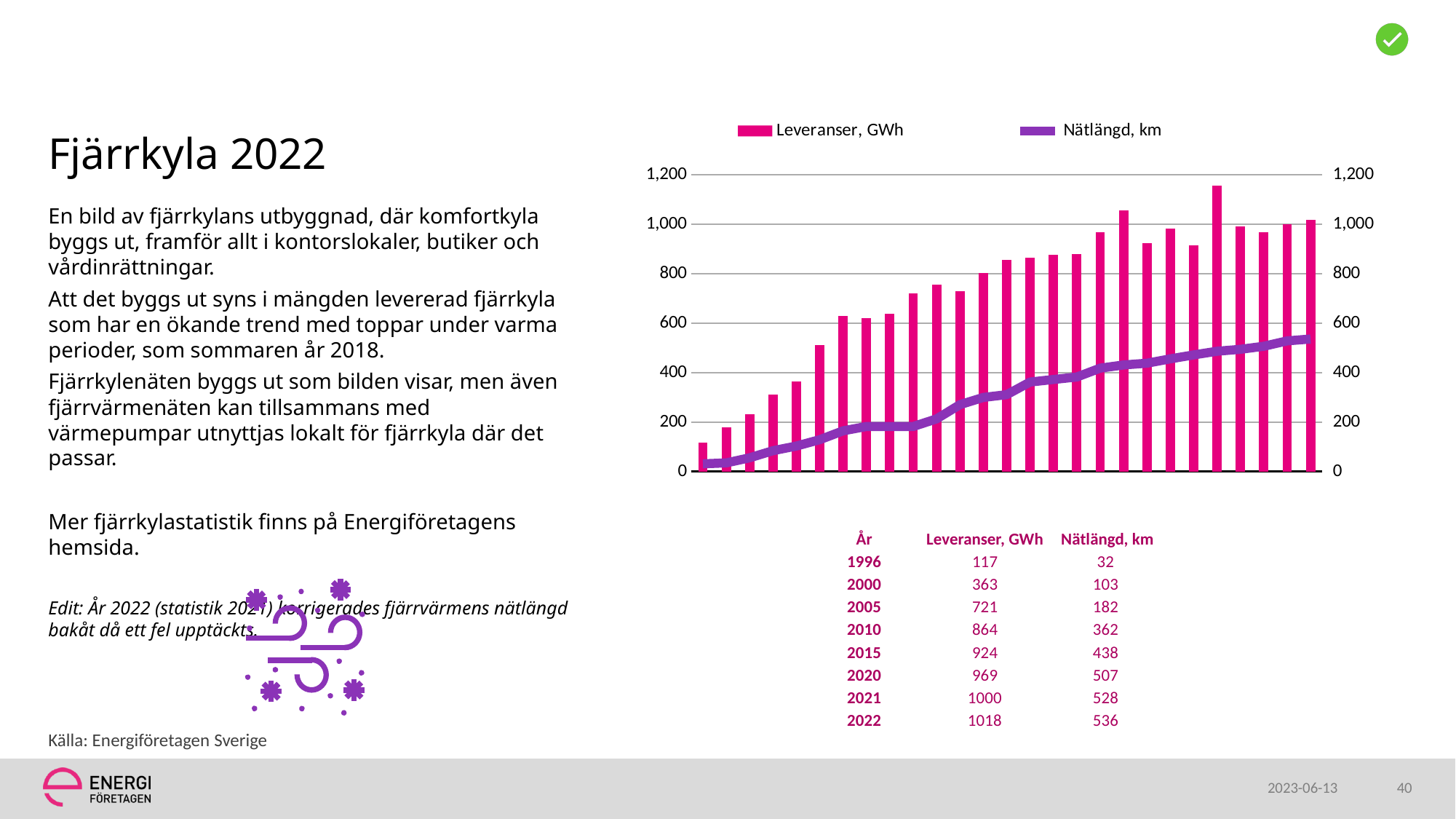
What are the two series named in the chart legend? Leveranser, GWh and Nätlängd, km Which year has the larger Nätlängd, km in the table: 2015 or 2020? 2020 How many bars are plotted in the chart? 27 What kind of chart is shown on the slide? A bar chart combined with a line By how much did Leveranser, GWh increase from 2021 to 2022 according to the table? 18 According to the table under the chart, what was Nätlängd, km in 2010? 362 Is the value of the first (leftmost) Leveranser, GWh bar greater or less than 200? less What is the difference in Nätlängd, km between 2022 and 1996 according to the table? 504 Is the value of the tallest Leveranser, GWh bar greater or less than 1,000? greater Does the Nätlängd, km line rise or fall from left to right across the chart? rise According to the table under the chart, what was Leveranser, GWh in 2022? 1018 How many series does the chart legend list? 2